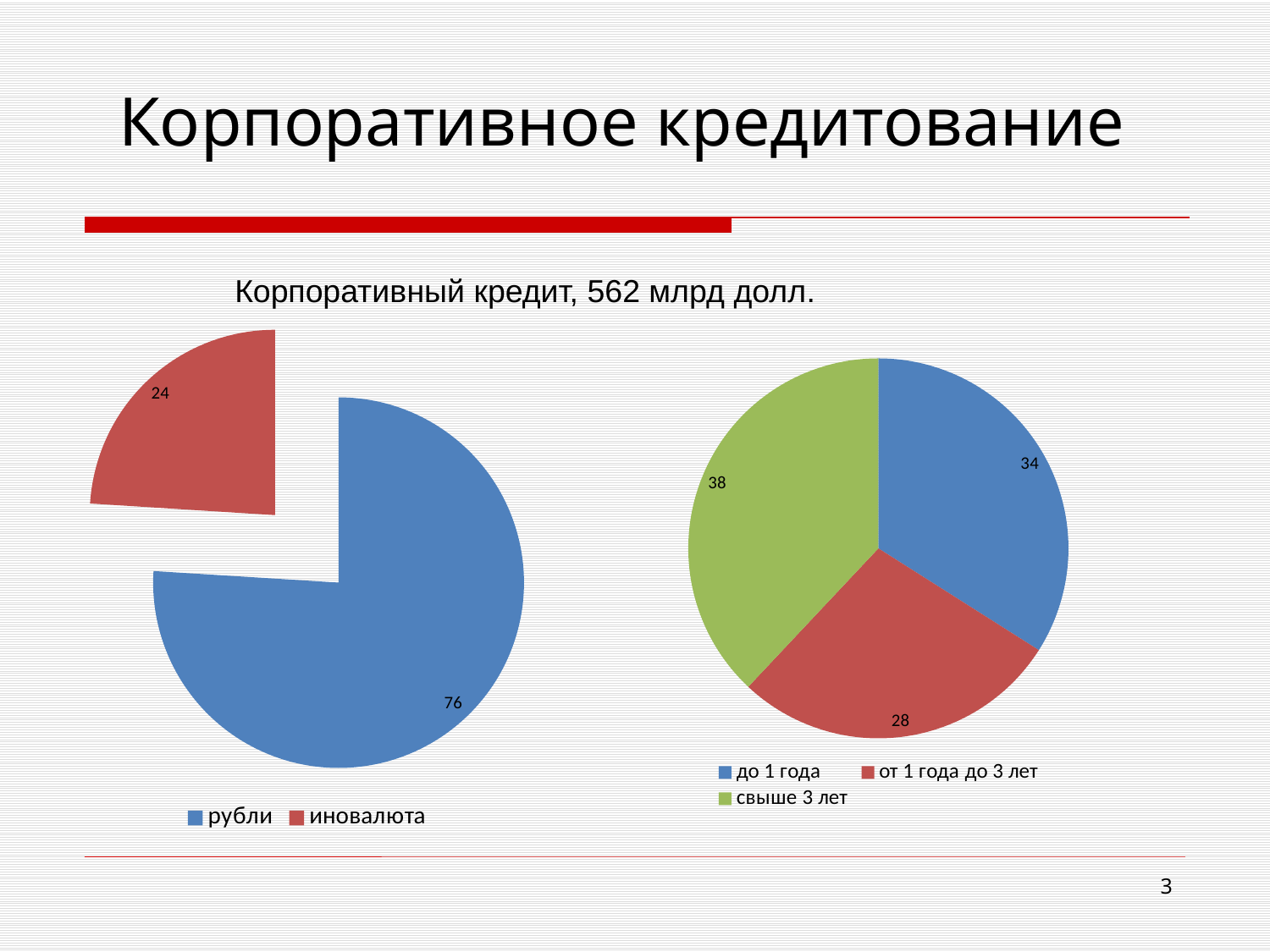
In the right pie chart, what is the value for до 1 года? 34 In the right pie chart, what is the value for от 1 года до 3 лет? 28 In the left pie chart, which slice is pulled out from the pie? иновалюта In the left pie chart, what is the value for рубли? 76 How many slices does the right pie chart have? 3 What kind of chart is the left chart? pie chart In the left pie chart, what is the difference between the values for рубли and иновалюта? 52 In the left pie chart, what is the value for иновалюта? 24 In the right pie chart, which category has the smallest slice? от 1 года до 3 лет In the right pie chart, what is the value for свыше 3 лет? 38 In the right pie chart, which category has the largest slice? свыше 3 лет In the right pie chart, which is larger: до 1 года or от 1 года до 3 лет? до 1 года